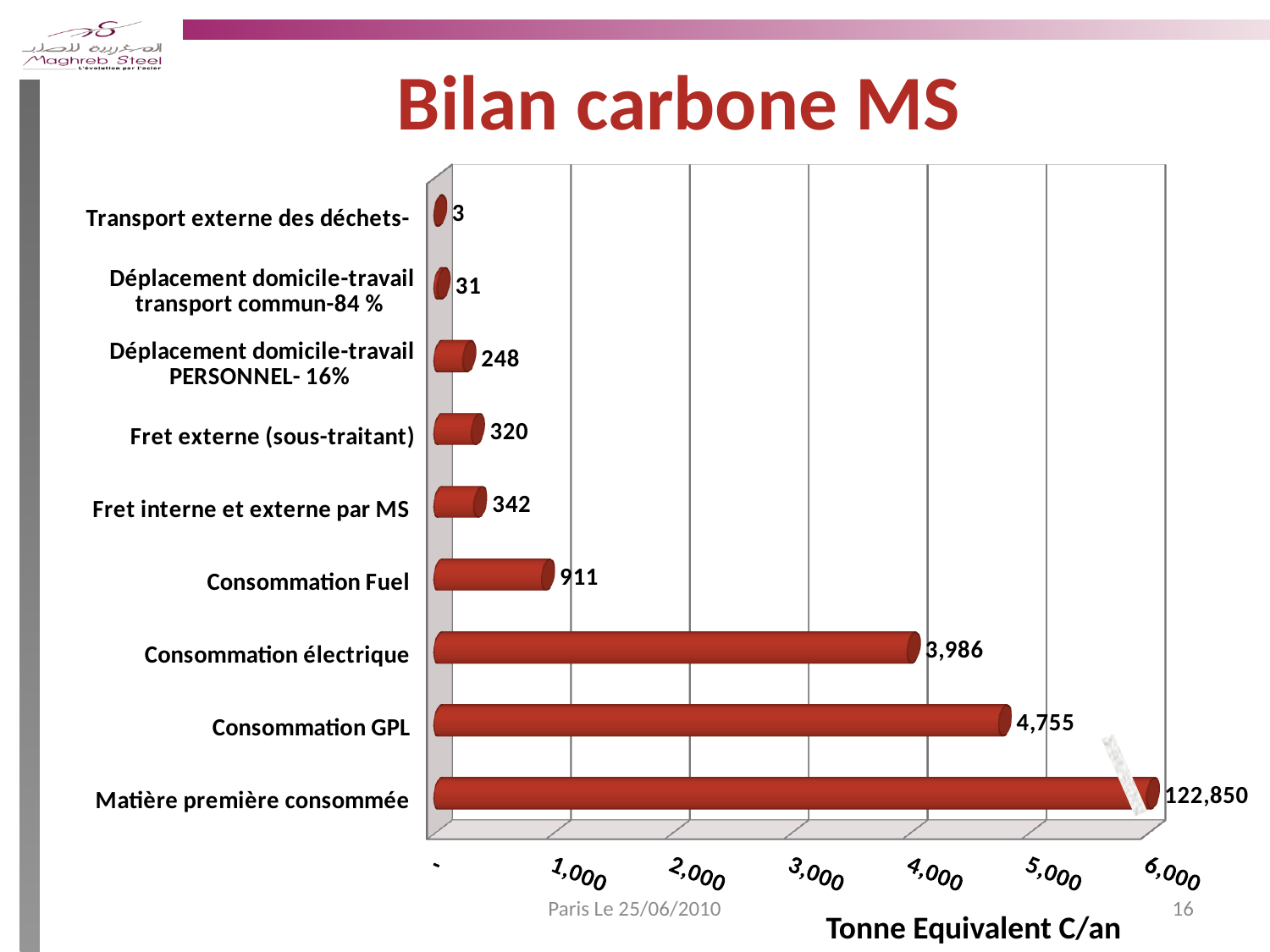
What is the value for Matière première consommée? 122,850 Which category has the lowest value? Transport externe des déchets What is the x-axis label of the chart? Tonne Equivalent C/an What is the value for Fret externe (sous-traitant)? 320 Which category has the highest value? Matière première consommée Is the value for Consommation GPL greater or less than 4,000? greater What is the value for Consommation électrique? 3,986 How many categories are shown in the chart? 9 What is the difference between Consommation GPL and Consommation électrique? 769 Which is larger, Fret interne et externe par MS or Fret externe (sous-traitant)? Fret interne et externe par MS What kind of chart is shown on the slide? Bar chart What is the value for Consommation Fuel? 911